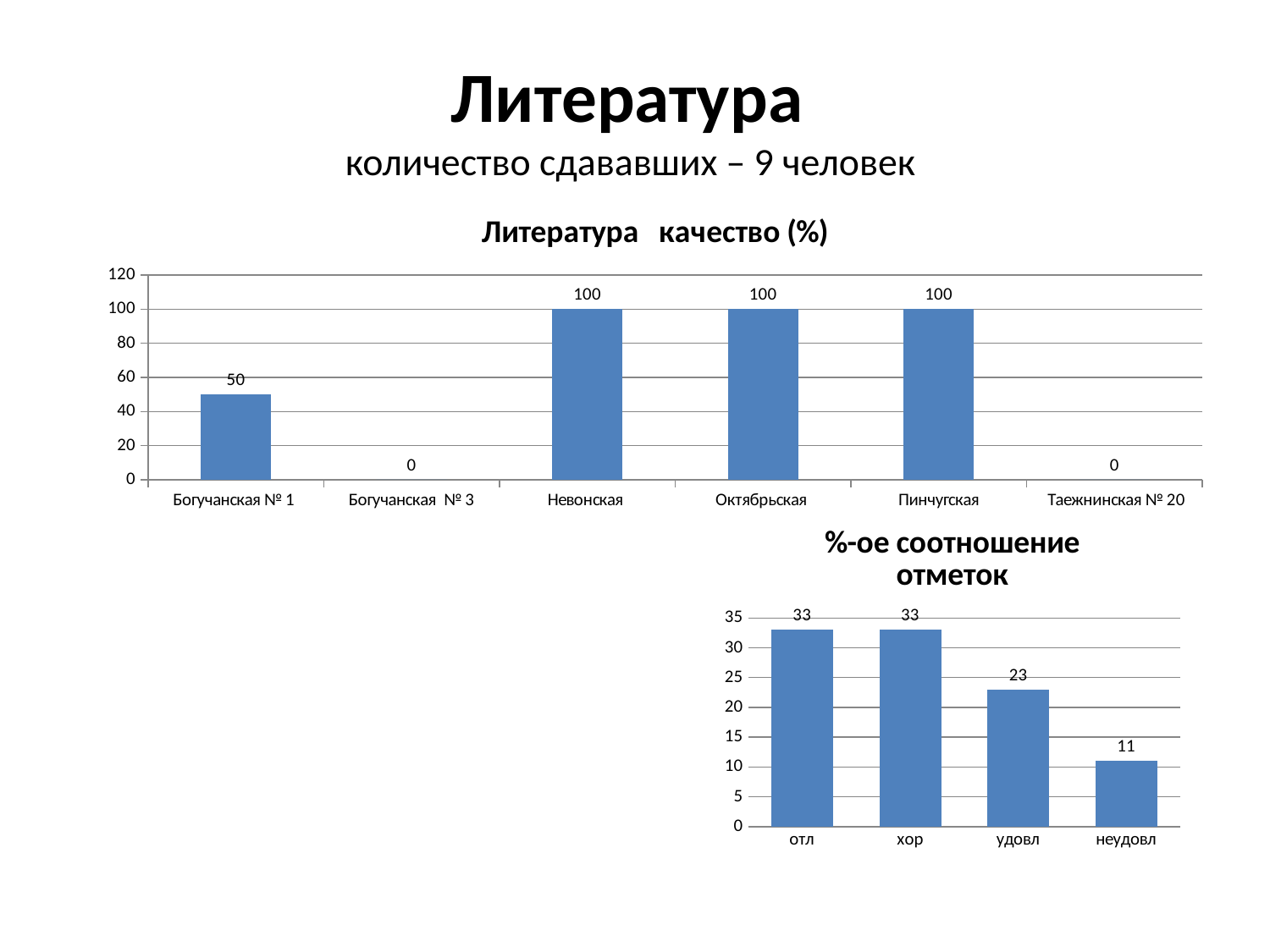
In the chart titled "%-ое соотношение отметок", which category has the lowest value? неудовл In the chart titled "Литература качество (%)", what kind of chart is it? bar chart In the chart titled "Литература качество (%)", what is the value for Богучанская № 1? 50 In the chart titled "Литература качество (%)", which is larger, the value for Пинчугская or the value for Богучанская № 1? Пинчугская In the chart titled "Литература качество (%)", what is the difference between the values for Октябрьская and Богучанская № 1? 50 In the chart titled "Литература качество (%)", what is the value for Невонская? 100 In the chart titled "%-ое соотношение отметок", what is the difference between the values for отл and удовл? 10 In the chart titled "%-ое соотношение отметок", what is the value for неудовл? 11 In the chart titled "%-ое соотношение отметок", what is the value for удовл? 23 In the chart titled "%-ое соотношение отметок", do the values rise or fall from left to right along the x axis? fall In the chart titled "Литература качество (%)", how many categories are shown on the x axis? 6 In the chart titled "Литература качество (%)", what is the value for Таежнинская № 20? 0